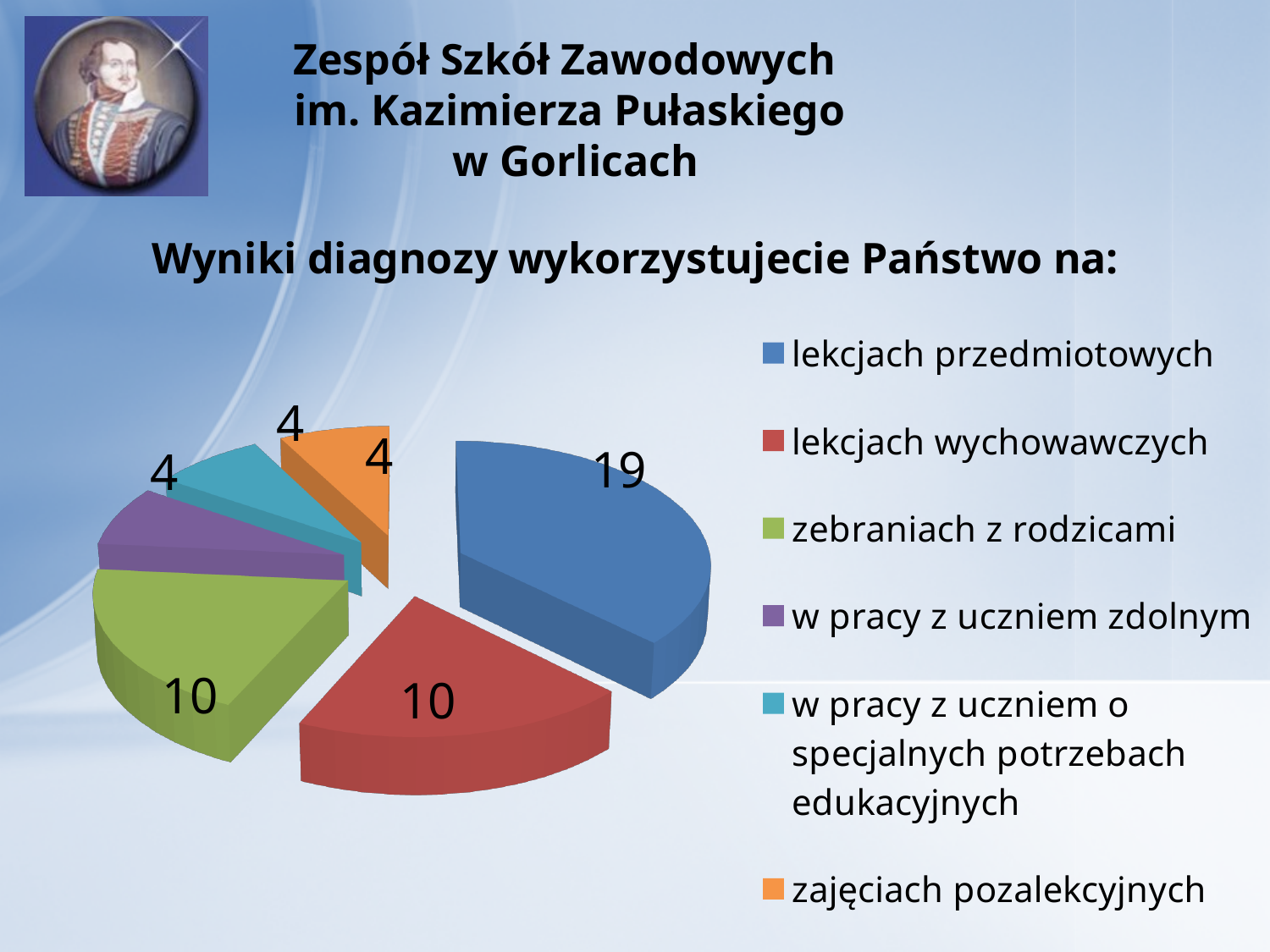
What is the value for "zebraniach z rodzicami"? 10 What is the title of the chart? Wyniki diagnozy wykorzystujecie Państwo na: Which category has the largest slice of the pie? lekcjach przedmiotowych What is the value for "w pracy z uczniem zdolnym"? 4 What is the value for "lekcjach wychowawczych"? 10 What type of chart is shown on the slide? pie chart Which is larger: the value for "zebraniach z rodzicami" or the value for "zajęciach pozalekcyjnych"? zebraniach z rodzicami How many categories does the legend list? 6 What is the difference between the values for "lekcjach przedmiotowych" and "lekcjach wychowawczych"? 9 What is the value for "zajęciach pozalekcyjnych"? 4 What is the value for "lekcjach przedmiotowych"? 19 How many categories have a value of 4? 3